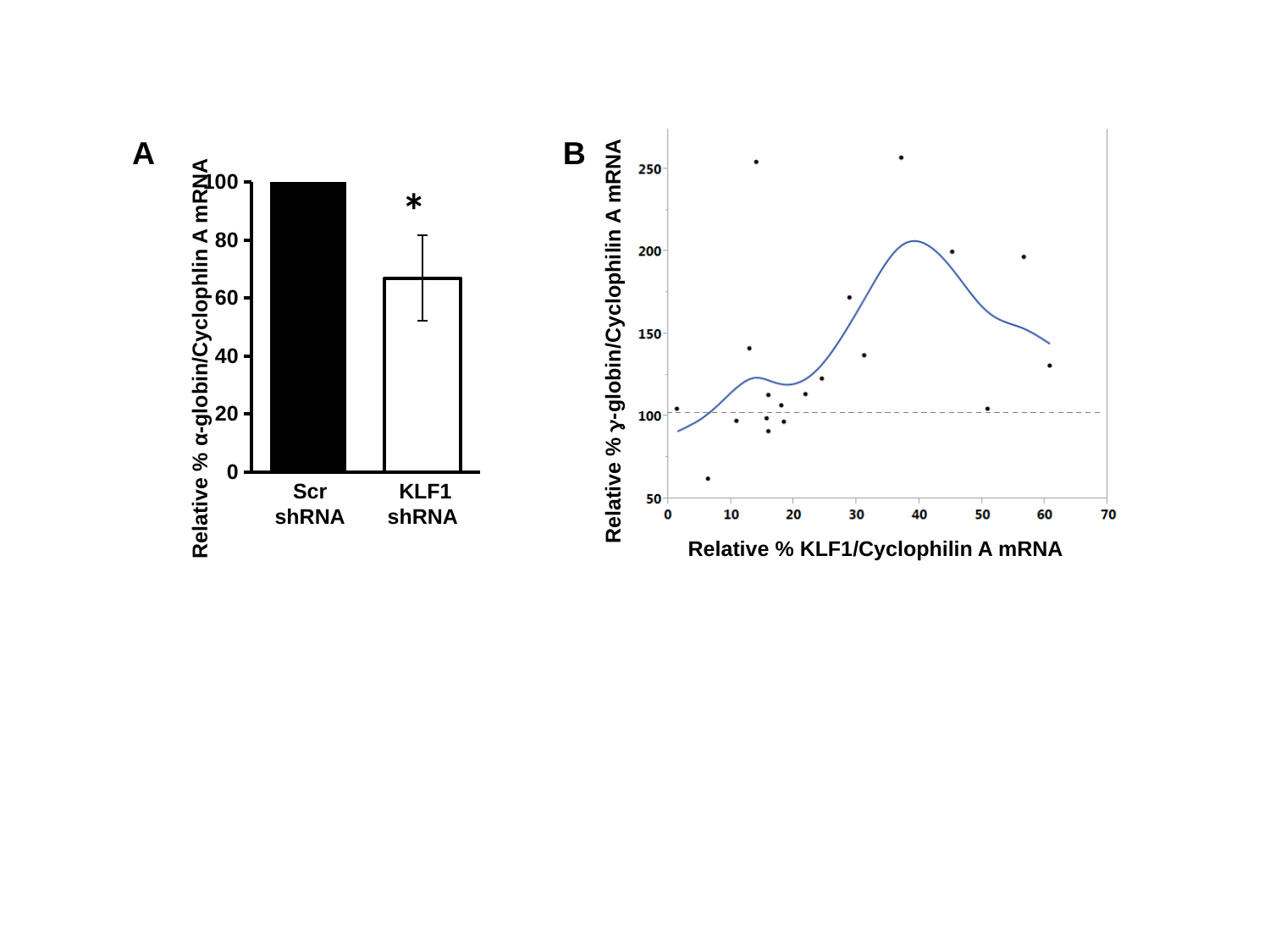
What kind of chart is chart A? Bar chart How many categories are shown in chart A? 2 In chart A, is the value for KLF1 shRNA greater or less than 80? less In chart B, what is the highest value shown on the y axis? 250 What is the x-axis label of chart B? Relative % KLF1/Cyclophilin A mRNA In chart A, which category has the higher value? Scr shRNA In chart A, what is the value for Scr shRNA? 100 In chart A, is the value for Scr shRNA larger than the value for KLF1 shRNA? Yes In chart A, which bar is filled black? Scr shRNA In chart A, which category has the lower value? KLF1 shRNA In chart A, is the value for KLF1 shRNA greater or less than 60? greater What kind of chart is chart B? Scatter plot